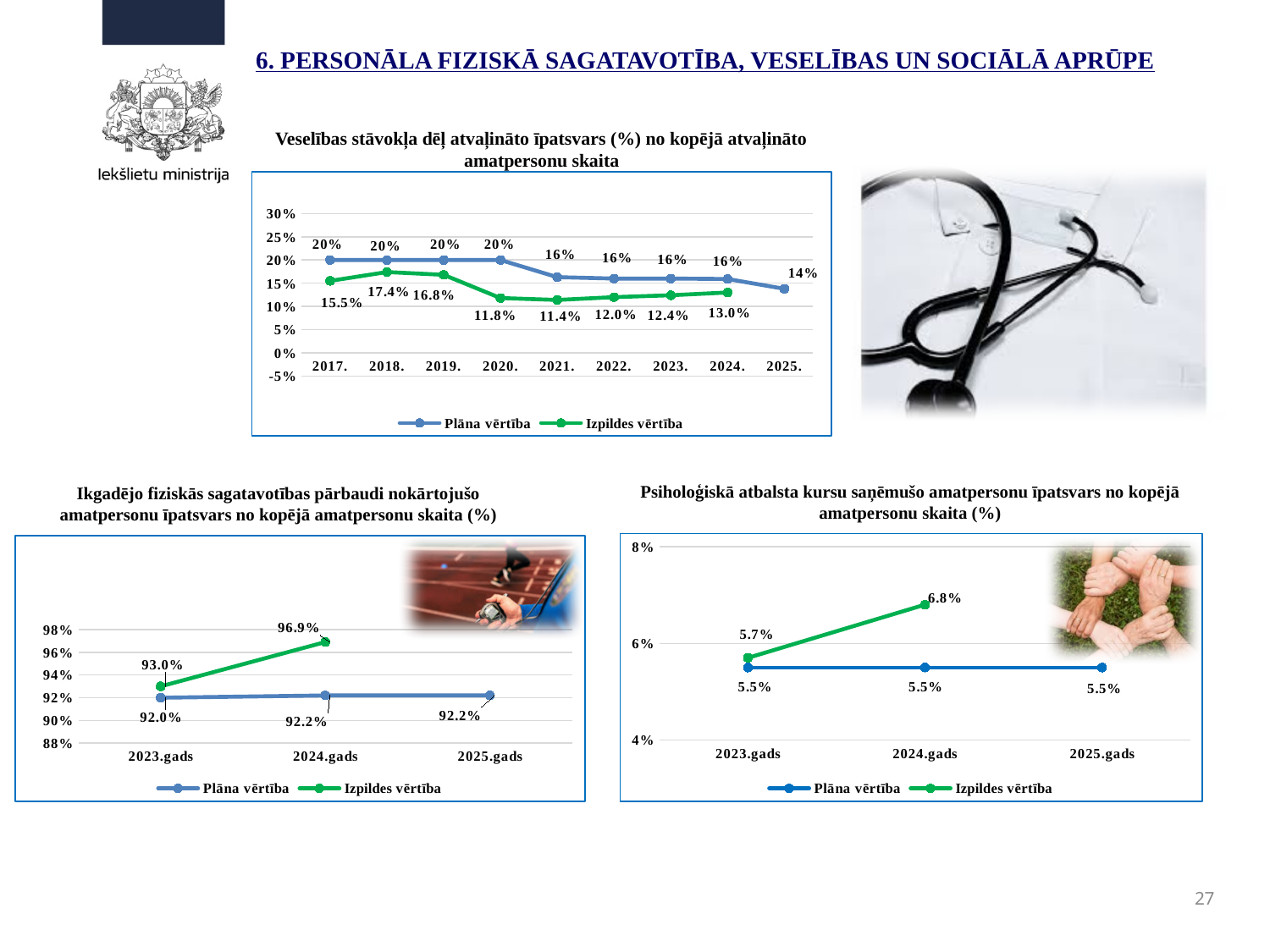
In the bottom-left chart (Ikgadējo fiziskās sagatavotības pārbaudi nokārtojušo), what is the Izpildes vērtība for 2024.gads? 96.9% In the top chart (Veselības stāvokļa dēļ atvaļināto īpatsvars), which year has the lowest Izpildes vērtība? 2021. In the top chart (Veselības stāvokļa dēļ atvaļināto īpatsvars), what is the Plāna vērtība for 2025? 14% In the top chart (Veselības stāvokļa dēļ atvaļināto īpatsvars), how many years are shown on the x axis? 9 In the bottom-right chart (Psiholoģiskā atbalsta kursu saņēmušo), which is larger in 2023.gads, the Plāna vērtība or the Izpildes vērtība? Izpildes vērtība In the top chart (Veselības stāvokļa dēļ atvaļināto īpatsvars), what is the Izpildes vērtība for 2018? 17.4% In the top chart (Veselības stāvokļa dēļ atvaļināto īpatsvars), which year has the highest Izpildes vērtība? 2018. In the top chart (Veselības stāvokļa dēļ atvaļināto īpatsvars), what is the difference between the Plāna vērtība and the Izpildes vērtība in 2020? 8.2% In the bottom-left chart (Ikgadējo fiziskās sagatavotības pārbaudi nokārtojušo), what is the difference between the Izpildes vērtība and the Plāna vērtība in 2023.gads? 1.0% In the bottom-right chart (Psiholoģiskā atbalsta kursu saņēmušo), what is the Izpildes vērtība for 2024.gads? 6.8% What type of chart is the bottom-right chart (Psiholoģiskā atbalsta kursu saņēmušo)? line chart In the top chart (Veselības stāvokļa dēļ atvaļināto īpatsvars), does the Plāna vērtība rise or fall from 2017 to 2025? fall